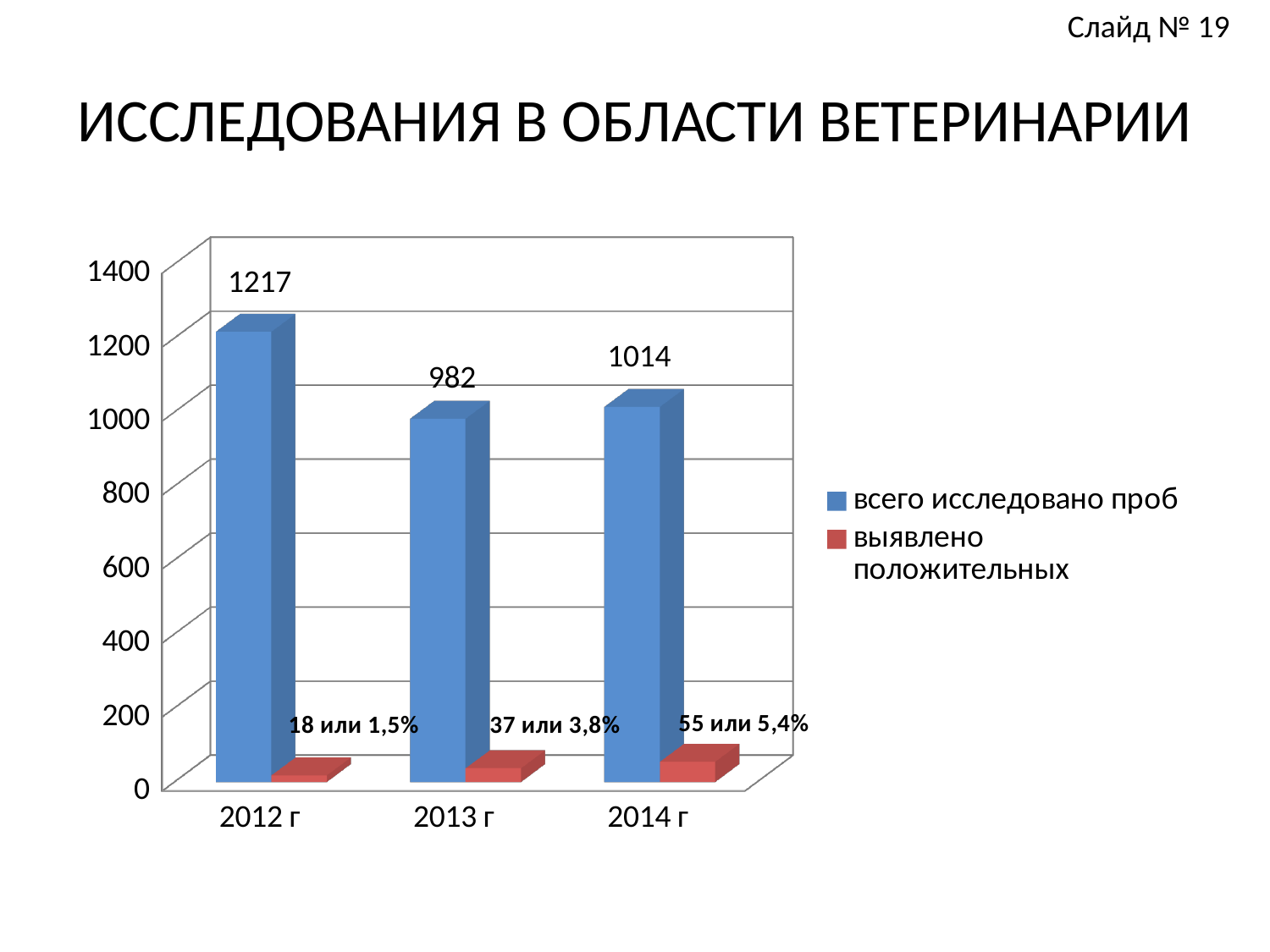
Which year has the highest value for "всего исследовано проб"? 2012 г How many series does the legend list? 2 What is the value of "всего исследовано проб" for 2013 г? 982 Which year has the lowest value for "всего исследовано проб"? 2013 г What is the value of "всего исследовано проб" for 2012 г? 1217 What is the title of the slide? ИССЛЕДОВАНИЯ В ОБЛАСТИ ВЕТЕРИНАРИИ What is the value of "всего исследовано проб" for 2014 г? 1014 Which is larger: "всего исследовано проб" in 2014 г or in 2013 г? 2014 г What label is shown for "выявлено положительных" in 2014 г? 55 или 5,4% What kind of chart is shown on the slide? bar chart What is the difference between "всего исследовано проб" in 2012 г and 2013 г? 235 How many years are shown on the x axis? 3